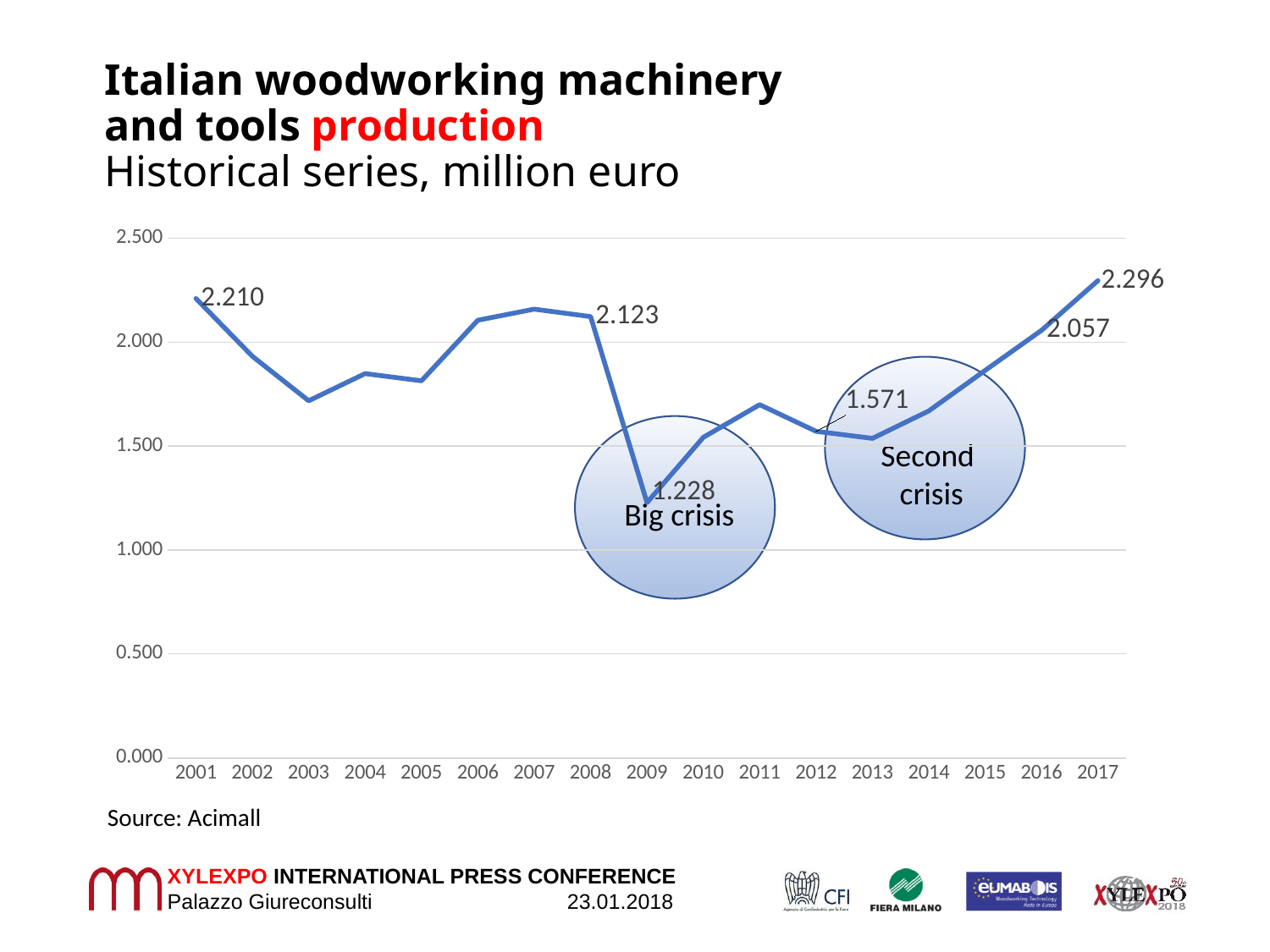
What kind of chart is shown on the slide? line chart Is the production value for 2003 greater or less than 2.000? less Which year has the lowest production value? 2009 Which year has the highest production value? 2017 What is the production value for 2016? 2.057 What is the difference between the 2017 and 2016 production values? 0.239 What is the production value for 2001? 2.210 What is the production value for 2009? 1.228 Do the production values rise or fall from 2013 to 2017? rise What is the production value for 2008? 2.123 What is the production value for 2017? 2.296 How many years are shown on the x axis? 17